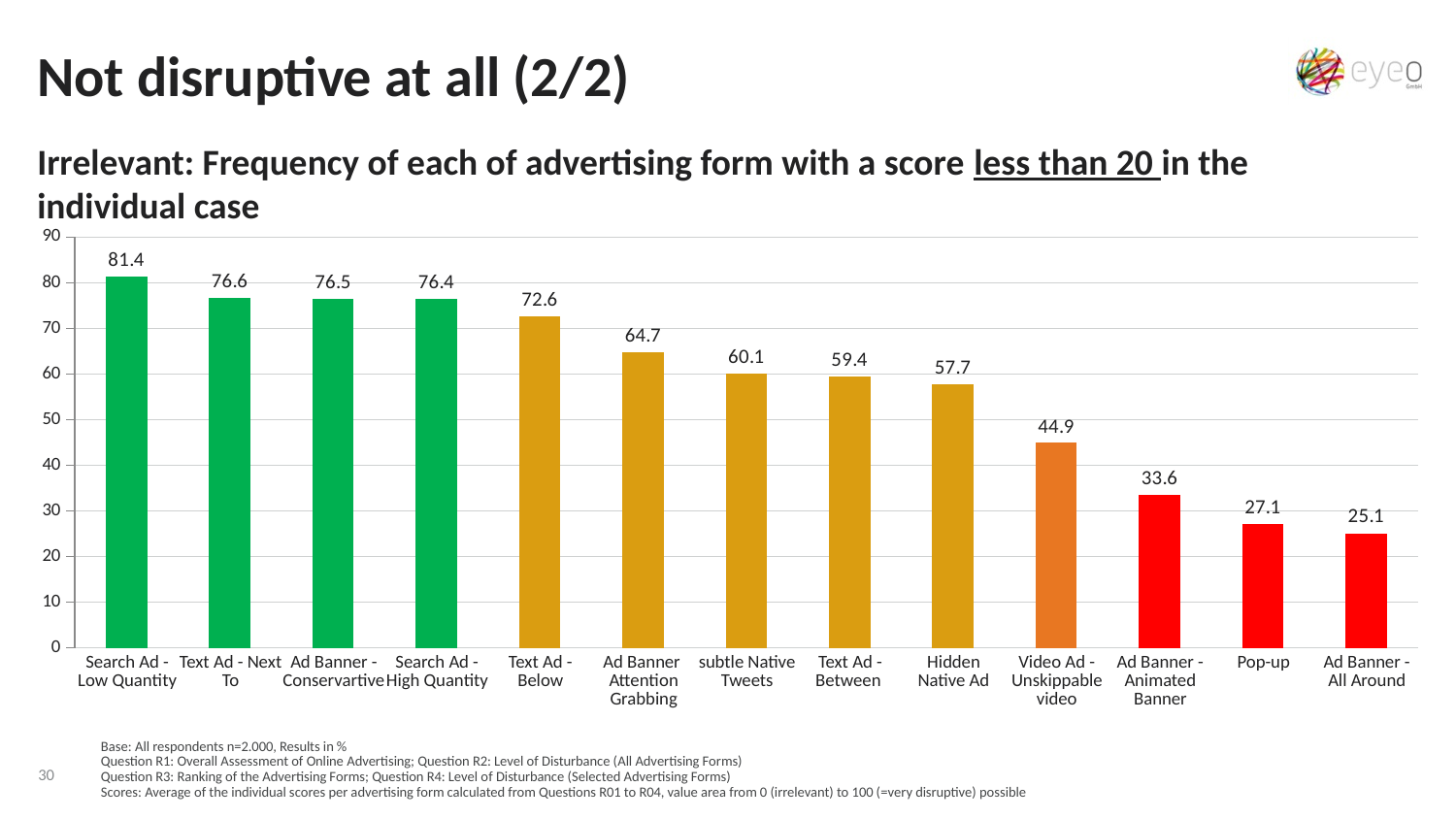
Do the values rise or fall from left to right along the x axis? Fall Which is larger, the value for Text Ad - Below or the value for Ad Banner Attention Grabbing? Text Ad - Below What kind of chart is shown on the slide? Bar chart Is the value for Ad Banner - Animated Banner greater or less than 40? less What is the value for Hidden Native Ad? 57.7 What is the difference between the values for Search Ad - Low Quantity and Ad Banner - All Around? 56.3 Which advertising form has the highest value? Search Ad - Low Quantity What is the value for Pop-up? 27.1 Which advertising form has the lowest value? Ad Banner - All Around What is the value for Video Ad - Unskippable video? 44.9 What is the value for Search Ad - Low Quantity? 81.4 How many advertising forms are shown in the chart? 13